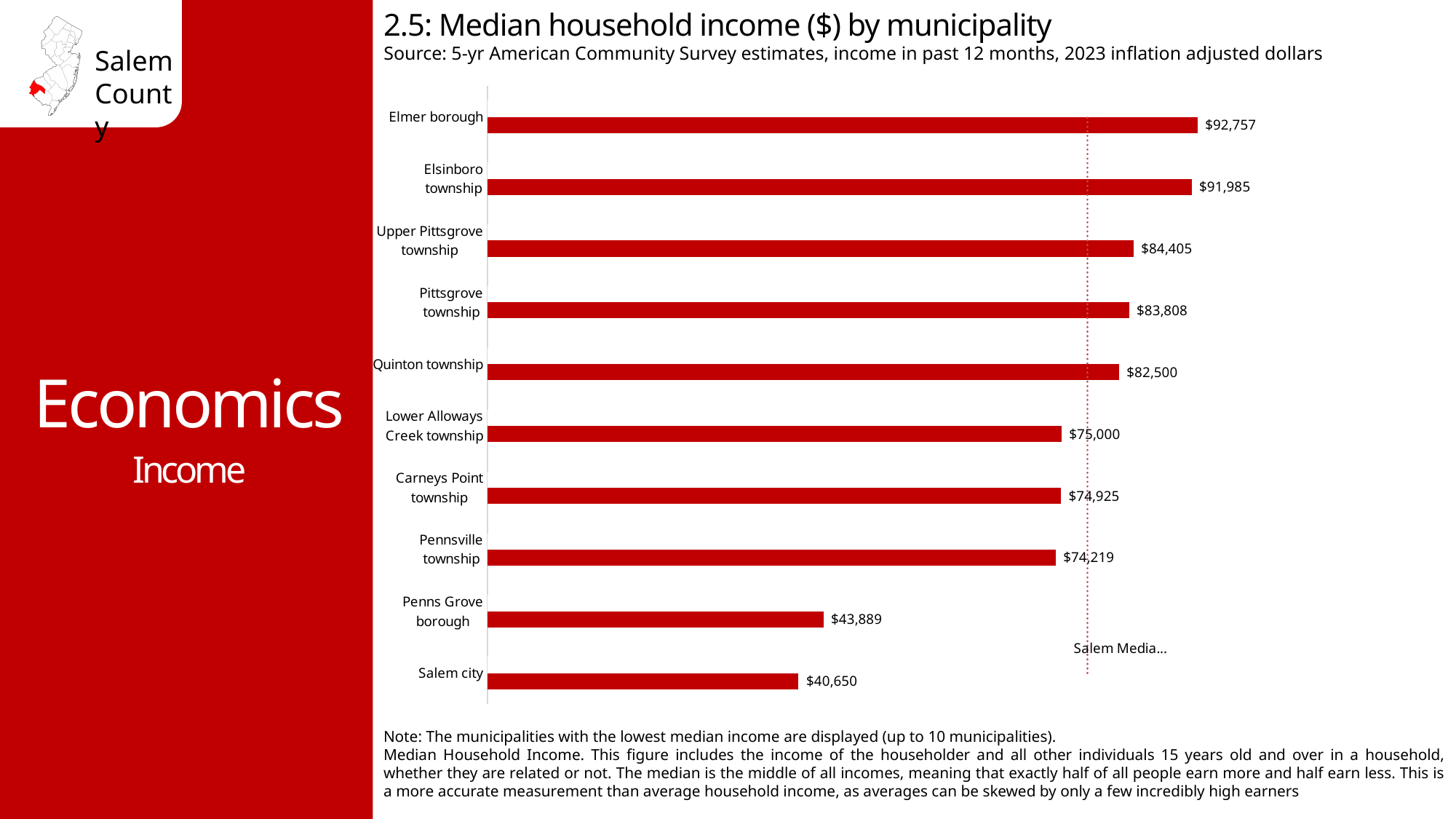
What is the median household income for Salem city? $40,650 How many municipalities are shown on the chart? 10 What is the median household income for Elmer borough? $92,757 What type of chart is used to show median household income by municipality? Bar chart What is the difference in median household income between Elmer borough and Salem city? $52,107 Which has a higher median household income, Lower Alloways Creek township or Pennsville township? Lower Alloways Creek township What is the title of the chart? 2.5: Median household income ($) by municipality What is the median household income for Quinton township? $82,500 What is the difference in median household income between Upper Pittsgrove township and Pittsgrove township? $597 Which municipality has the lowest median household income on the chart? Salem city What is the median household income for Penns Grove borough? $43,889 Which municipality has the highest median household income on the chart? Elmer borough